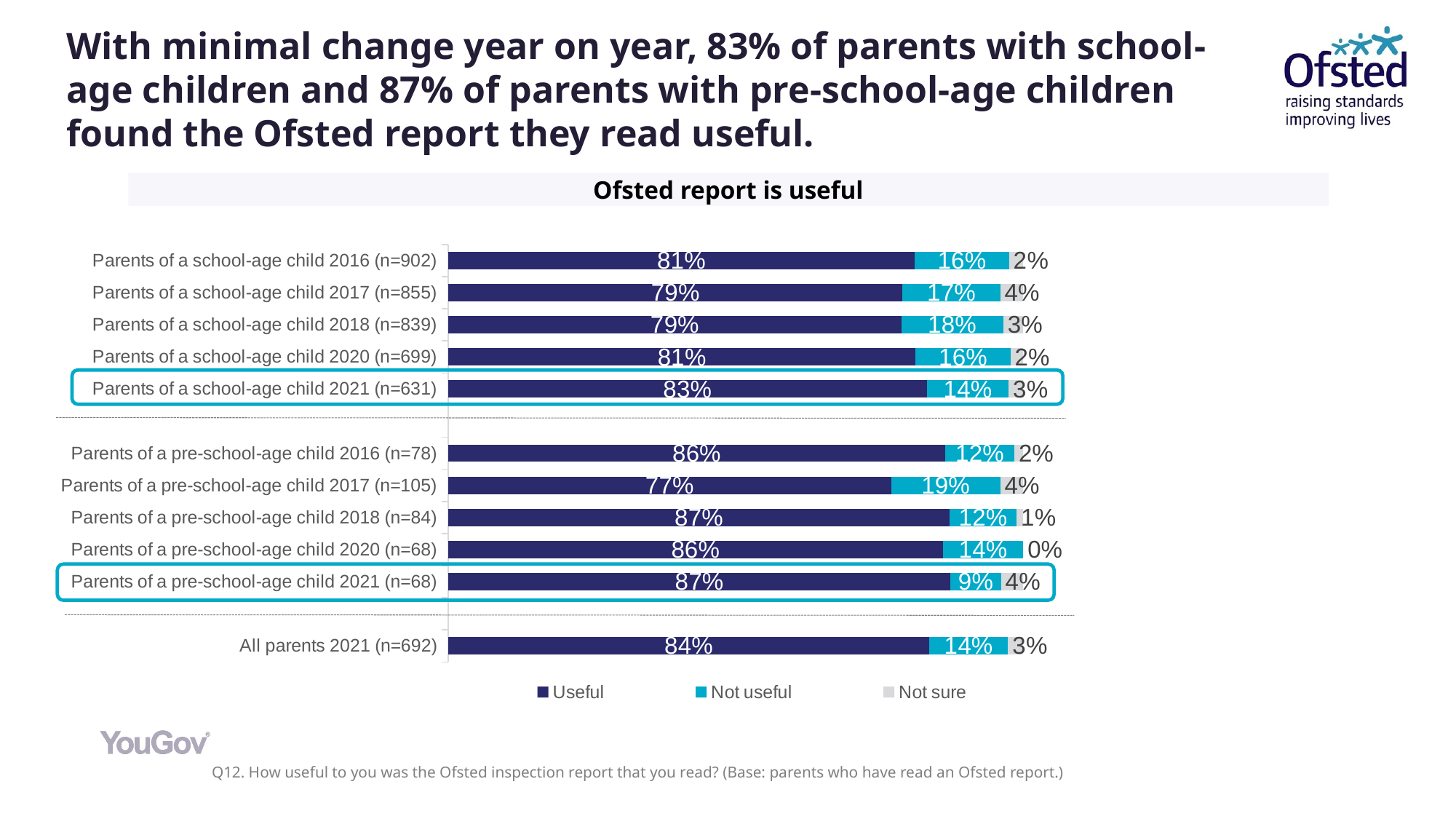
What percentage of parents of a school-age child in 2021 (n=631) said the Ofsted report was useful? 83% What is the 'Not useful' value for parents of a pre-school-age child in 2017 (n=105)? 19% Which has a larger 'Not useful' value: parents of a school-age child 2018 or parents of a pre-school-age child 2018? Parents of a school-age child 2018 Which category has the highest 'Not useful' percentage? Parents of a pre-school-age child 2017 (n=105) What is the title of the chart? Ofsted report is useful What is the 'Not sure' value for All parents 2021 (n=692)? 3% Which category has the lowest 'Useful' percentage? Parents of a pre-school-age child 2017 (n=105) What type of chart is shown on the slide? Stacked bar chart How many categories (bars) are shown in the chart? 11 How many series does the legend list? 3 How many percentage points higher is the 'Useful' value for parents of a pre-school-age child 2021 than for parents of a school-age child 2021? 4 percentage points Which category has the lowest 'Not useful' percentage? Parents of a pre-school-age child 2021 (n=68)